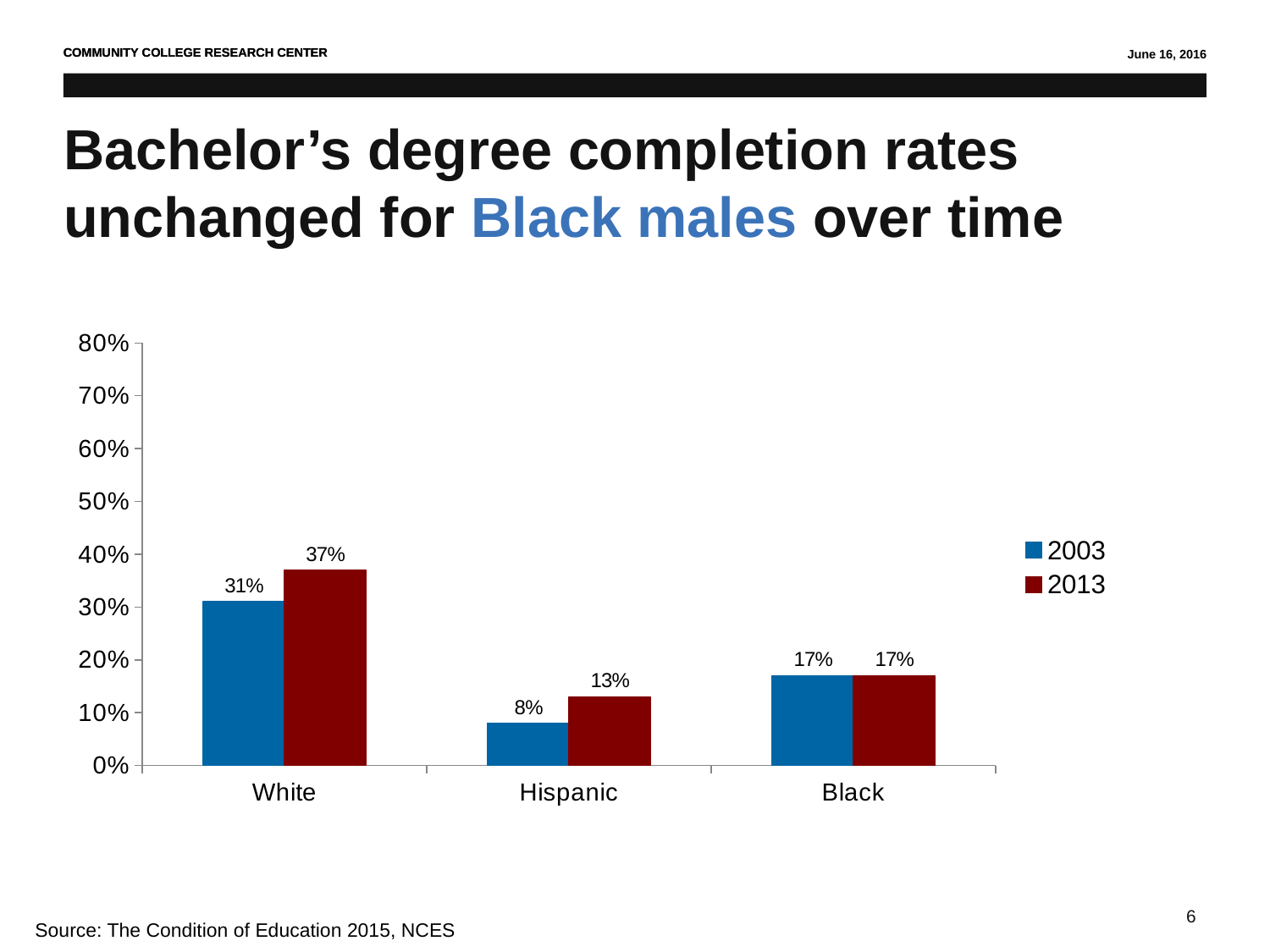
How many categories are shown on the x axis? 3 How many series does the legend list? 2 What is the difference between the 2013 and 2003 values for Hispanic? 5% Which is larger, the 2003 value for White or the 2013 value for Black? 2003 value for White What is the value for White in 2003? 31% What is the value for Hispanic in 2013? 13% Is the 2013 value for White greater or less than 30%? greater What is the difference between the 2013 and 2003 values for White? 6% Which category has the highest value in 2013? White Which category has the lowest value in 2003? Hispanic What is the value for Black in 2003? 17% What kind of chart is shown on the slide? Bar chart